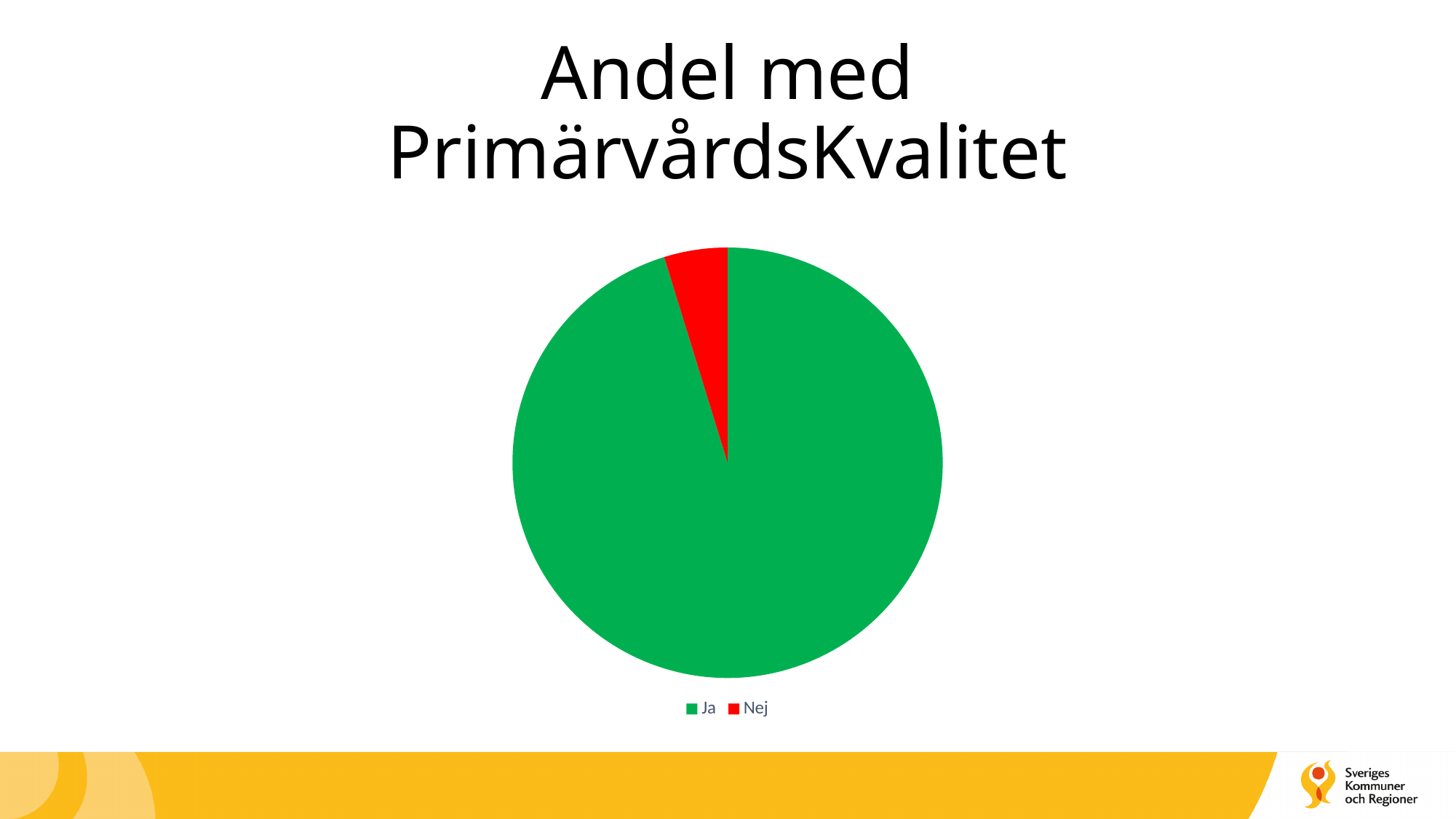
Which slice is the smallest in the pie chart? Nej What kind of chart is shown on the slide? pie chart What colour is the Nej slice in the pie chart? red Which slice is the largest in the pie chart? Ja Which is larger, the Ja slice or the Nej slice? Ja What is the title of the chart on the slide? Andel med PrimärvårdsKvalitet How many slices does the pie chart have? 2 How many entries does the legend list? 2